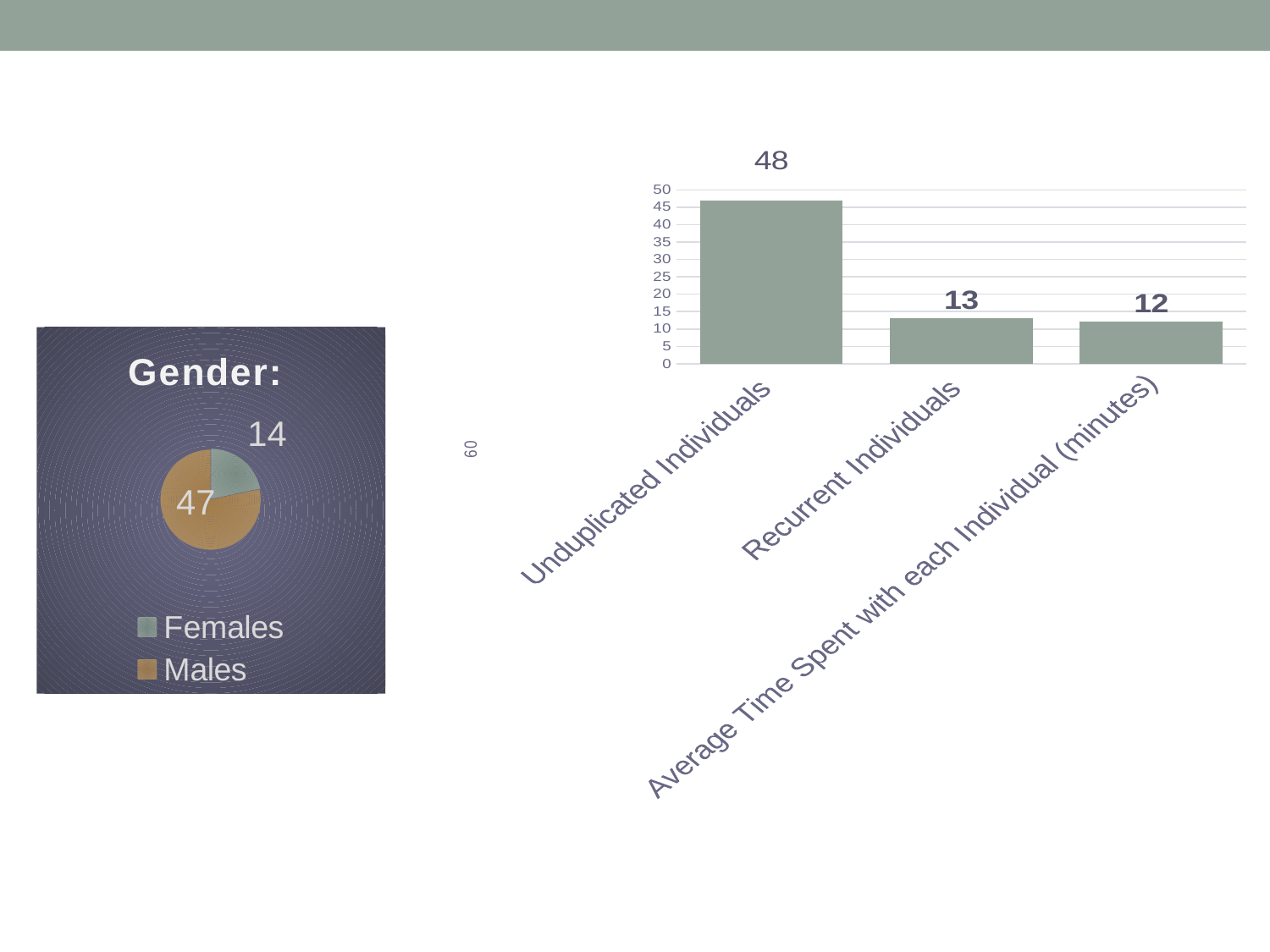
In the Gender pie chart, what is the difference between the Males and Females values? 33 In the Gender pie chart, how many categories does the legend list? 2 In the Gender pie chart, which category is larger, Females or Males? Males In the Gender pie chart, what is the value for Females? 14 In the bar chart on the right, what is the difference between Unduplicated Individuals and Recurrent Individuals? 35 In the bar chart on the right, what is the value for Unduplicated Individuals? 48 What type of chart is the chart on the left of the slide? Pie chart In the bar chart on the right, what is the value for Average Time Spent with each Individual (minutes)? 12 In the Gender pie chart, what is the value for Males? 47 How many categories are shown in the bar chart on the right? 3 In the bar chart on the right, what is the value for Recurrent Individuals? 13 In the bar chart on the right, which category has the highest value? Unduplicated Individuals